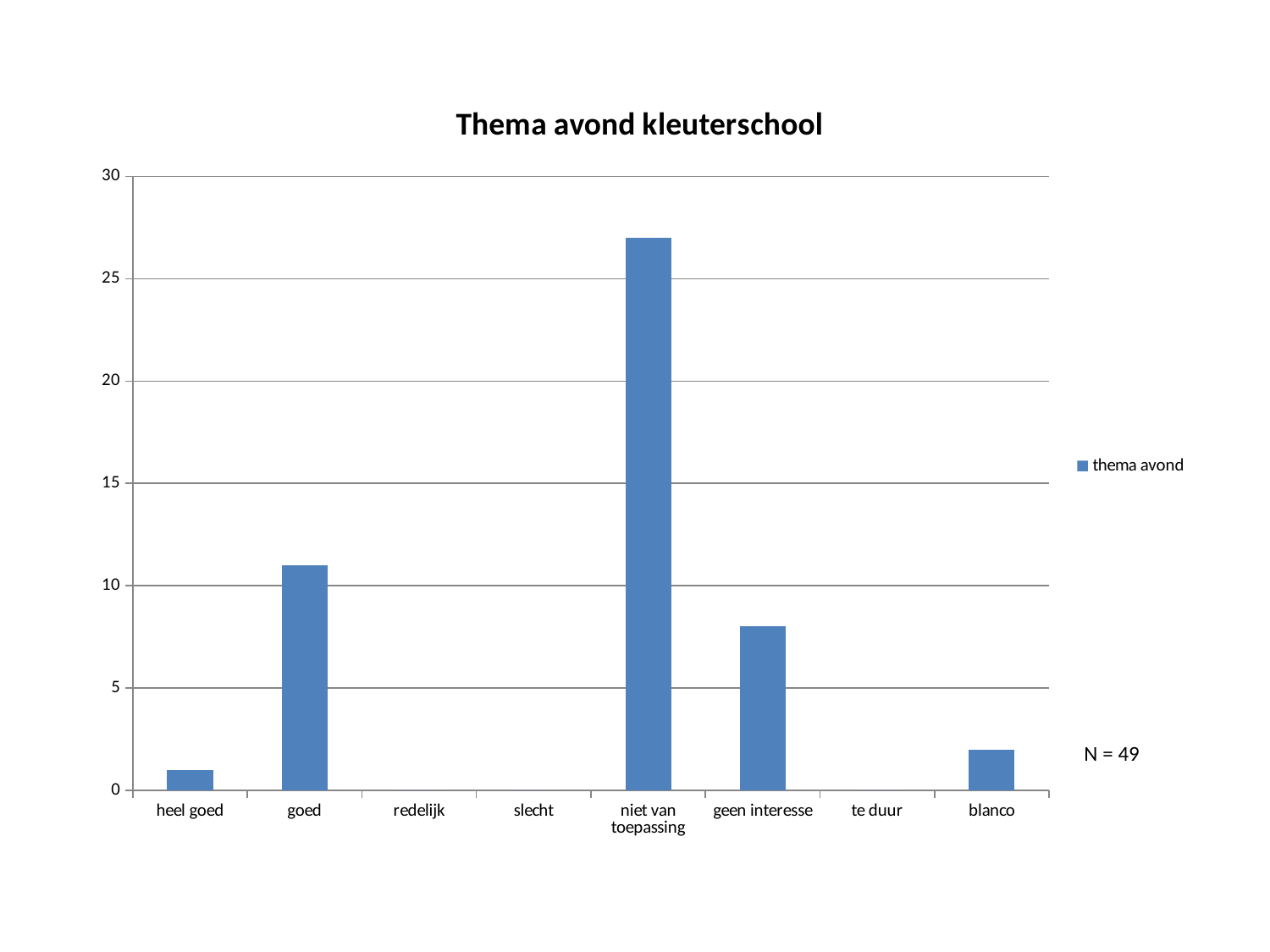
What is the title of the chart? Thema avond kleuterschool Which category has the highest bar? niet van toepassing Is the value for heel goed greater or less than 5? less What kind of chart is shown on the slide? bar chart Is the value for niet van toepassing greater or less than 25? greater How many series does the legend list? 1 Is the value for geen interesse greater or less than 10? less How many categories are shown on the x axis of the chart? 8 Which is larger, the value for goed or the value for geen interesse? goed What is the name of the series shown in the legend? thema avond